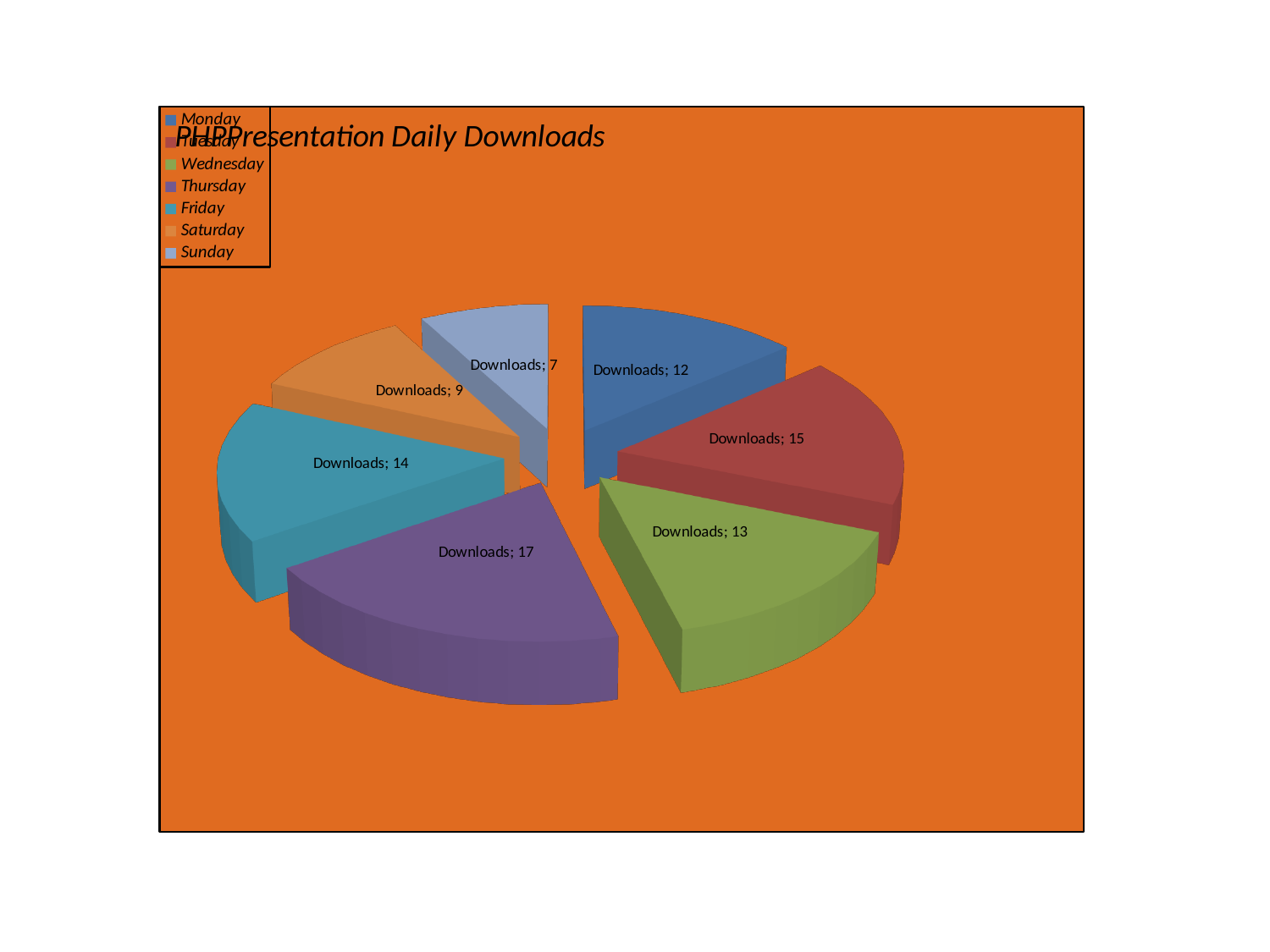
What is the Downloads value for Friday? 14 What is the Downloads value for Thursday? 17 What is the Downloads value for Monday? 12 Which day has the highest number of downloads? Thursday What kind of chart is shown on the slide? Pie chart How many categories does the legend list? 7 Which has more downloads, Tuesday or Wednesday? Tuesday What is the Downloads value for Sunday? 7 Which day has the lowest number of downloads? Sunday What is the title of the chart? PHPPresentation Daily Downloads What is the total number of downloads across all seven days? 87 What is the difference in downloads between Thursday and Sunday? 10